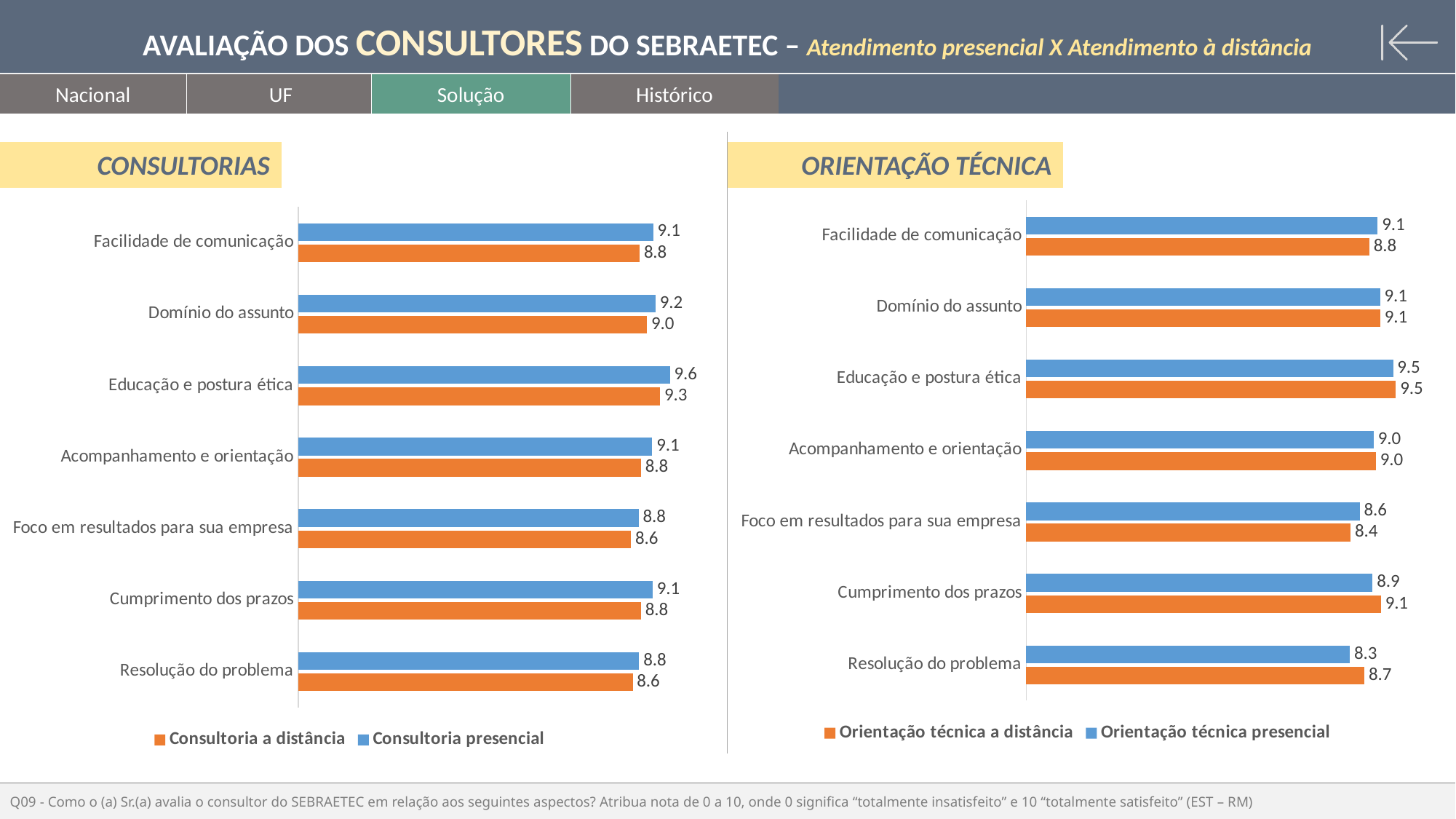
In the CONSULTORIAS chart, what is the value for Consultoria presencial for Educação e postura ética? 9.6 In the CONSULTORIAS chart, which category has the highest value for Consultoria presencial? Educação e postura ética In the ORIENTAÇÃO TÉCNICA chart, what is the value for Orientação técnica presencial for Cumprimento dos prazos? 8.9 In the ORIENTAÇÃO TÉCNICA chart, which colour represents Orientação técnica a distância? Orange In the ORIENTAÇÃO TÉCNICA chart, which category has the lowest value for Orientação técnica presencial? Resolução do problema In the CONSULTORIAS chart, what is the difference between Consultoria presencial and Consultoria a distância for Educação e postura ética? 0.3 What kind of chart is the CONSULTORIAS chart? Bar chart In the ORIENTAÇÃO TÉCNICA chart, what is the value for Orientação técnica a distância for Resolução do problema? 8.7 In the CONSULTORIAS chart, what is the value for Consultoria a distância for Domínio do assunto? 9.0 How many series does the legend of the ORIENTAÇÃO TÉCNICA chart list? 2 How many categories are shown in the CONSULTORIAS chart? 7 In the ORIENTAÇÃO TÉCNICA chart, which is larger for Cumprimento dos prazos: Orientação técnica presencial or Orientação técnica a distância? Orientação técnica a distância